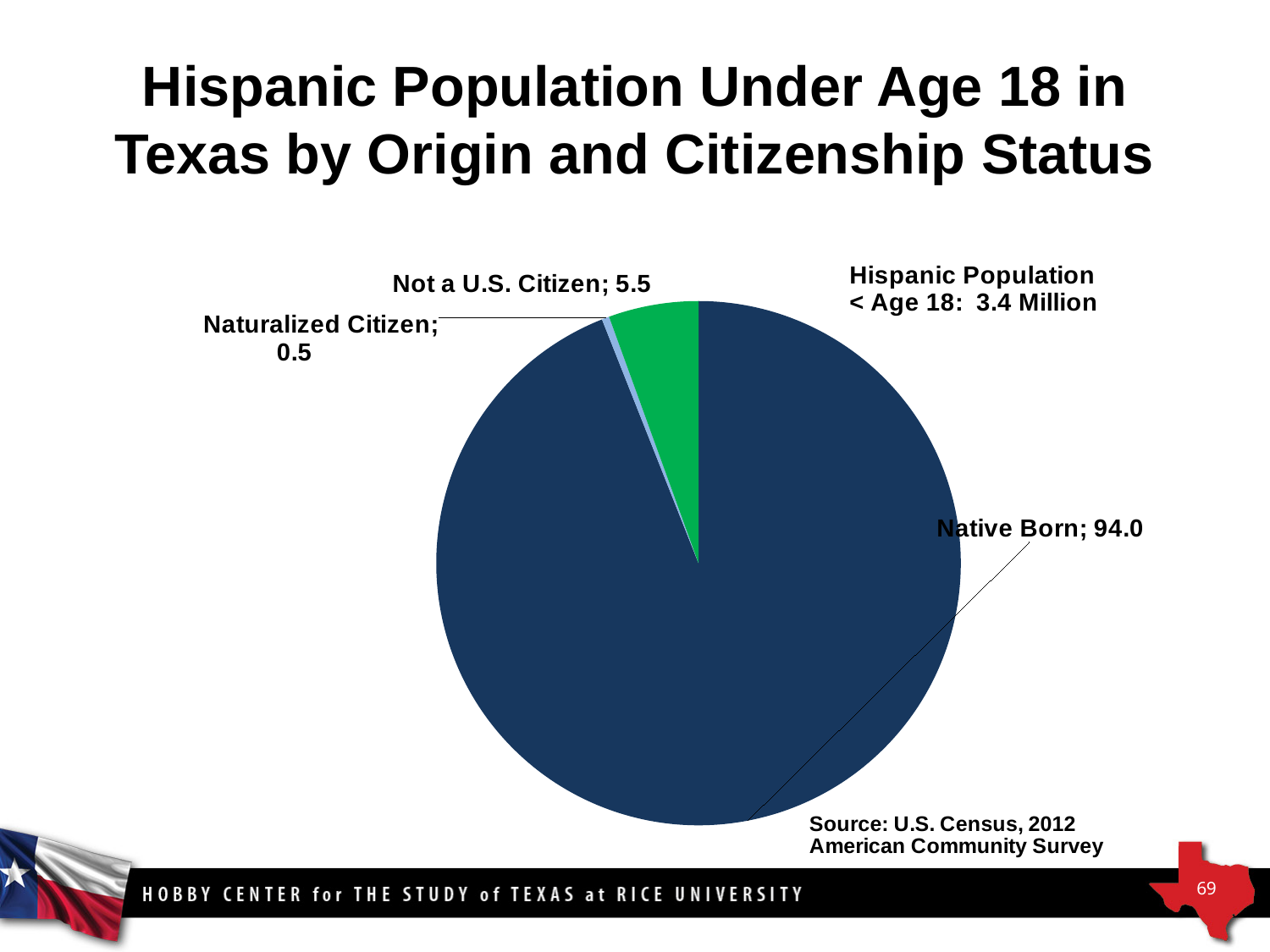
How many slices does the pie chart have? 3 What is the value for Naturalized Citizen? 0.5 Which category has the smallest slice of the pie? Naturalized Citizen What is the difference between the values for Native Born and Not a U.S. Citizen? 88.5 What total Hispanic population under age 18 is stated on the slide? 3.4 Million What kind of chart is shown on the slide? Pie chart What is the difference between the values for Not a U.S. Citizen and Naturalized Citizen? 5.0 What is the value for Native Born? 94.0 What is the title of the chart on the slide? Hispanic Population Under Age 18 in Texas by Origin and Citizenship Status What is the value for Not a U.S. Citizen? 5.5 Which is larger, the value for Not a U.S. Citizen or the value for Naturalized Citizen? Not a U.S. Citizen Which category has the largest slice of the pie? Native Born